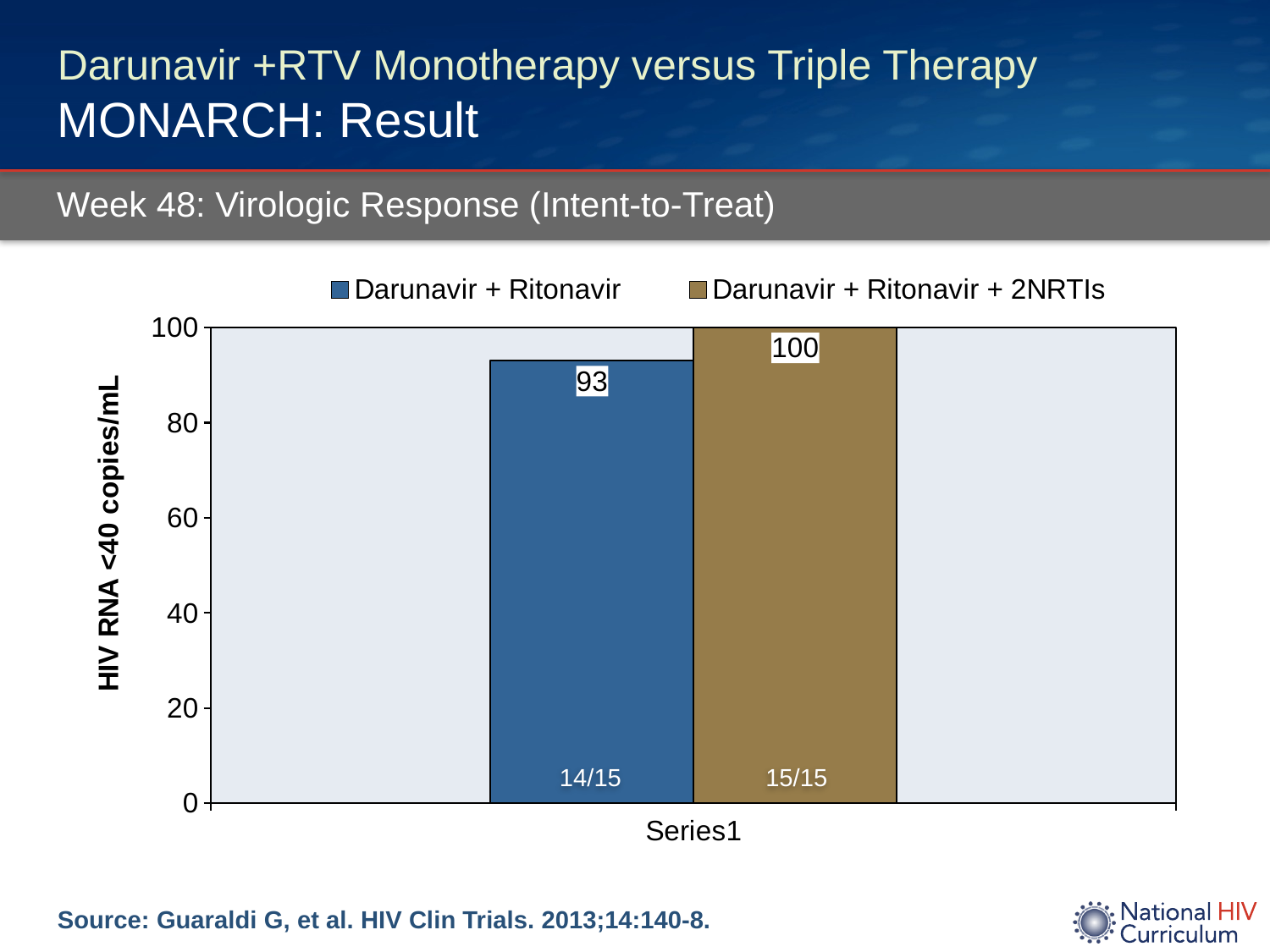
What kind of chart is shown on the slide? bar chart What is the value for Darunavir + Ritonavir + 2NRTIs? 100 Is the value for Darunavir + Ritonavir greater or less than 80? greater What is the value for Darunavir + Ritonavir? 93 Which is larger, the value for Darunavir + Ritonavir or the value for Darunavir + Ritonavir + 2NRTIs? Darunavir + Ritonavir + 2NRTIs What is the label on the vertical axis of the chart? HIV RNA <40 copies/mL What fraction is printed at the bottom of the Darunavir + Ritonavir bar? 14/15 Which series has the highest value? Darunavir + Ritonavir + 2NRTIs How many series does the legend list? 2 Which series has the lowest value? Darunavir + Ritonavir What is the difference between the values for Darunavir + Ritonavir + 2NRTIs and Darunavir + Ritonavir? 7 What fraction is printed at the bottom of the Darunavir + Ritonavir + 2NRTIs bar? 15/15